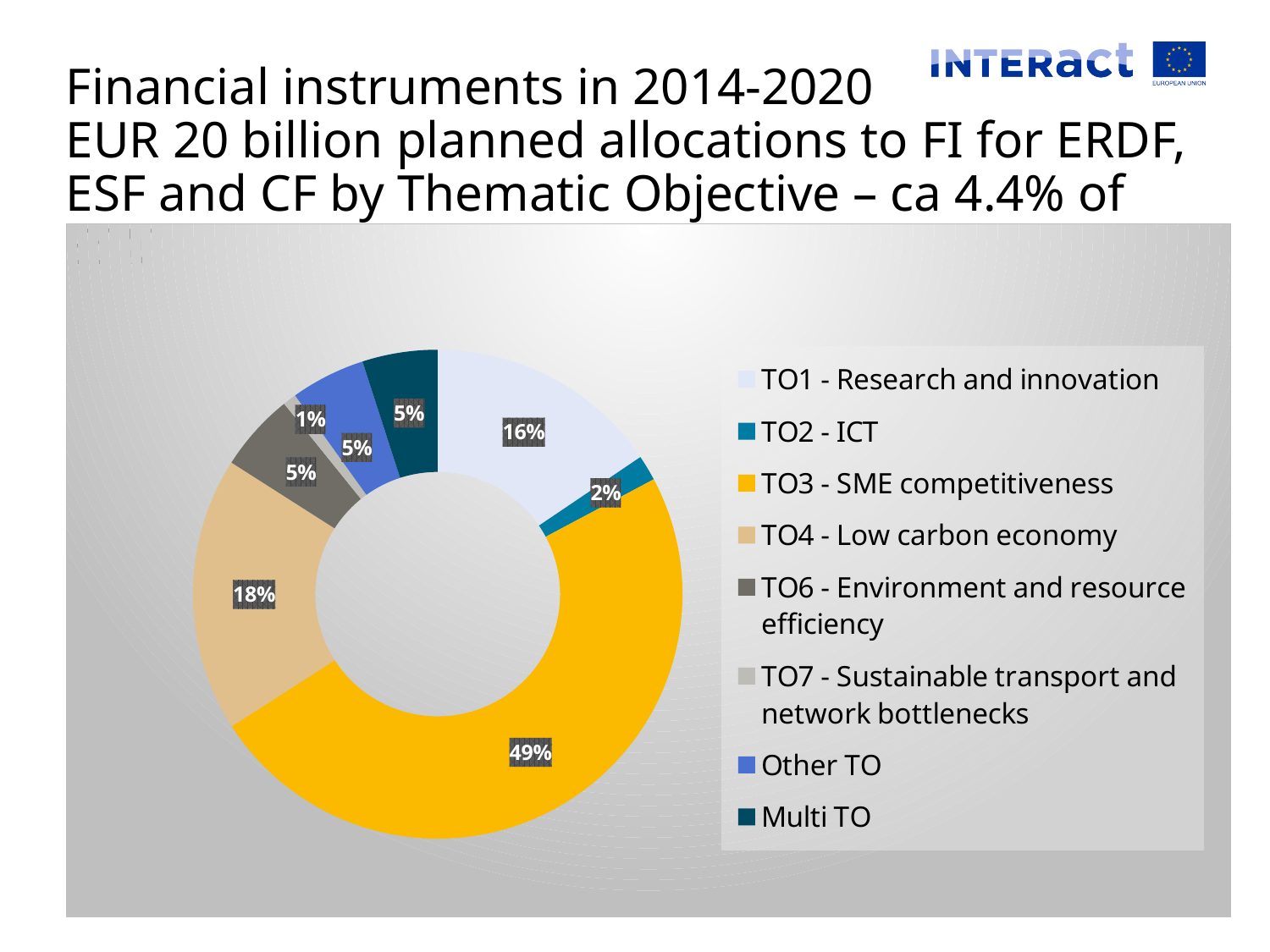
How many categories does the legend list? 8 What is the difference in percentage points between the shares of TO3 - SME competitiveness and TO4 - Low carbon economy? 31 percentage points Which thematic objective has the smallest share of the planned allocations? TO7 - Sustainable transport and network bottlenecks What share of the planned allocations goes to TO7 - Sustainable transport and network bottlenecks? 1% Which thematic objective has the largest share of the planned allocations? TO3 - SME competitiveness What colour is the slice for TO3 - SME competitiveness? Yellow What share of the planned allocations goes to TO3 - SME competitiveness? 49% Which has a larger share, TO1 - Research and innovation or TO4 - Low carbon economy? TO4 - Low carbon economy What share of the planned allocations goes to TO4 - Low carbon economy? 18% What kind of chart is shown on the slide? Doughnut (pie) chart What share of the planned allocations goes to TO1 - Research and innovation? 16% What share of the planned allocations goes to TO2 - ICT? 2%